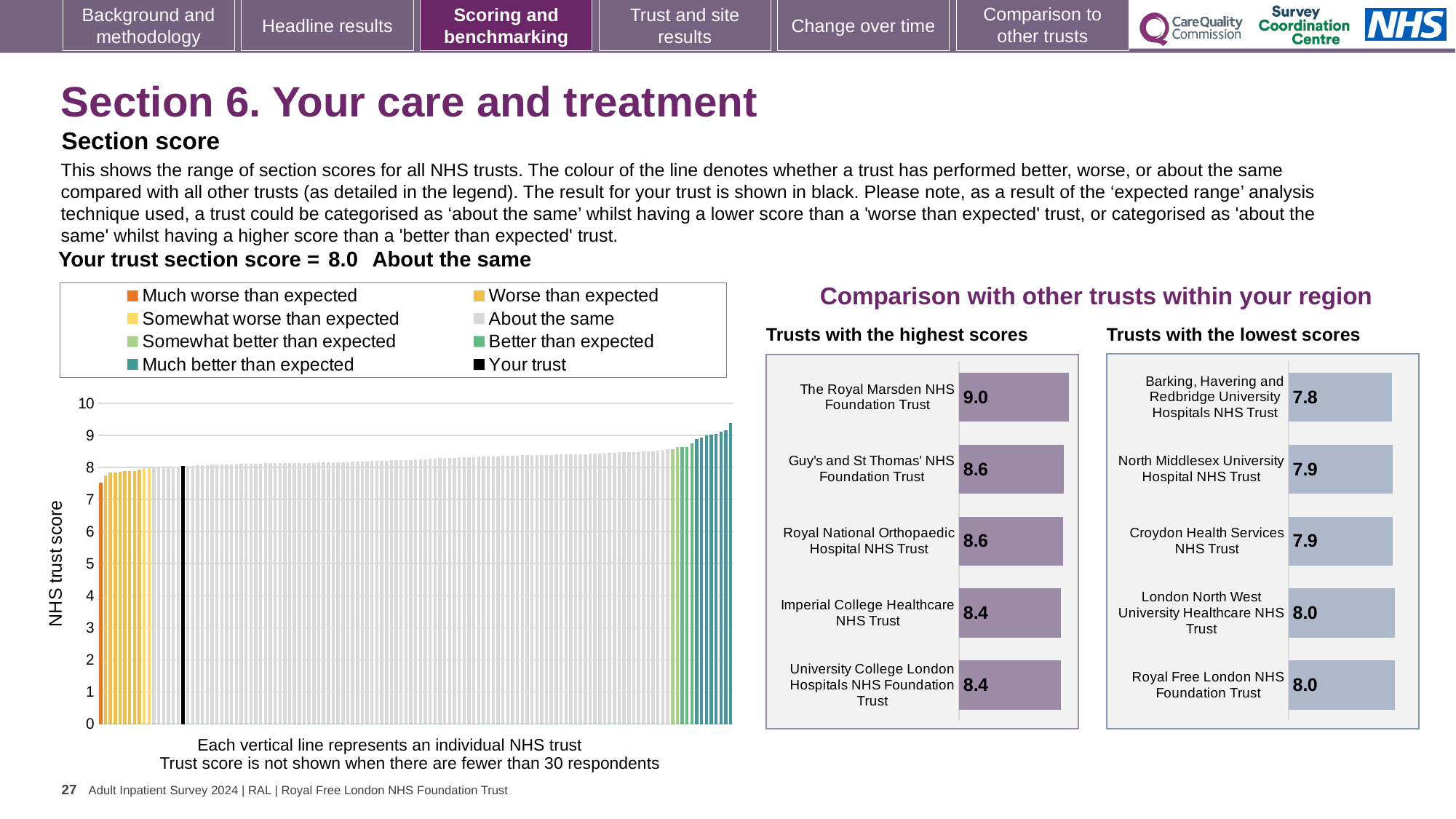
In the 'Trusts with the highest scores' chart, which trust has the highest score? The Royal Marsden NHS Foundation Trust In the NHS trust score chart, do the values rise or fall from left to right? Rise In the 'Trusts with the highest scores' chart, what is the score for The Royal Marsden NHS Foundation Trust? 9.0 How many trusts are listed in the 'Trusts with the highest scores' chart? 5 In the 'Trusts with the lowest scores' chart, what is the score for Croydon Health Services NHS Trust? 7.9 In the NHS trust score chart, is the value of the rightmost bar greater or less than 9? greater What kind of chart is the NHS trust score chart on the left? Bar chart How many entries does the legend of the NHS trust score chart list? 8 In the 'Trusts with the lowest scores' chart, what is the score for Barking, Havering and Redbridge University Hospitals NHS Trust? 7.8 In the 'Trusts with the lowest scores' chart, which has the larger score: Royal Free London NHS Foundation Trust or Barking, Havering and Redbridge University Hospitals NHS Trust? Royal Free London NHS Foundation Trust In the 'Trusts with the highest scores' chart, what is the difference between the scores of The Royal Marsden NHS Foundation Trust and Imperial College Healthcare NHS Trust? 0.6 In the 'Trusts with the lowest scores' chart, which trust has the lowest score? Barking, Havering and Redbridge University Hospitals NHS Trust